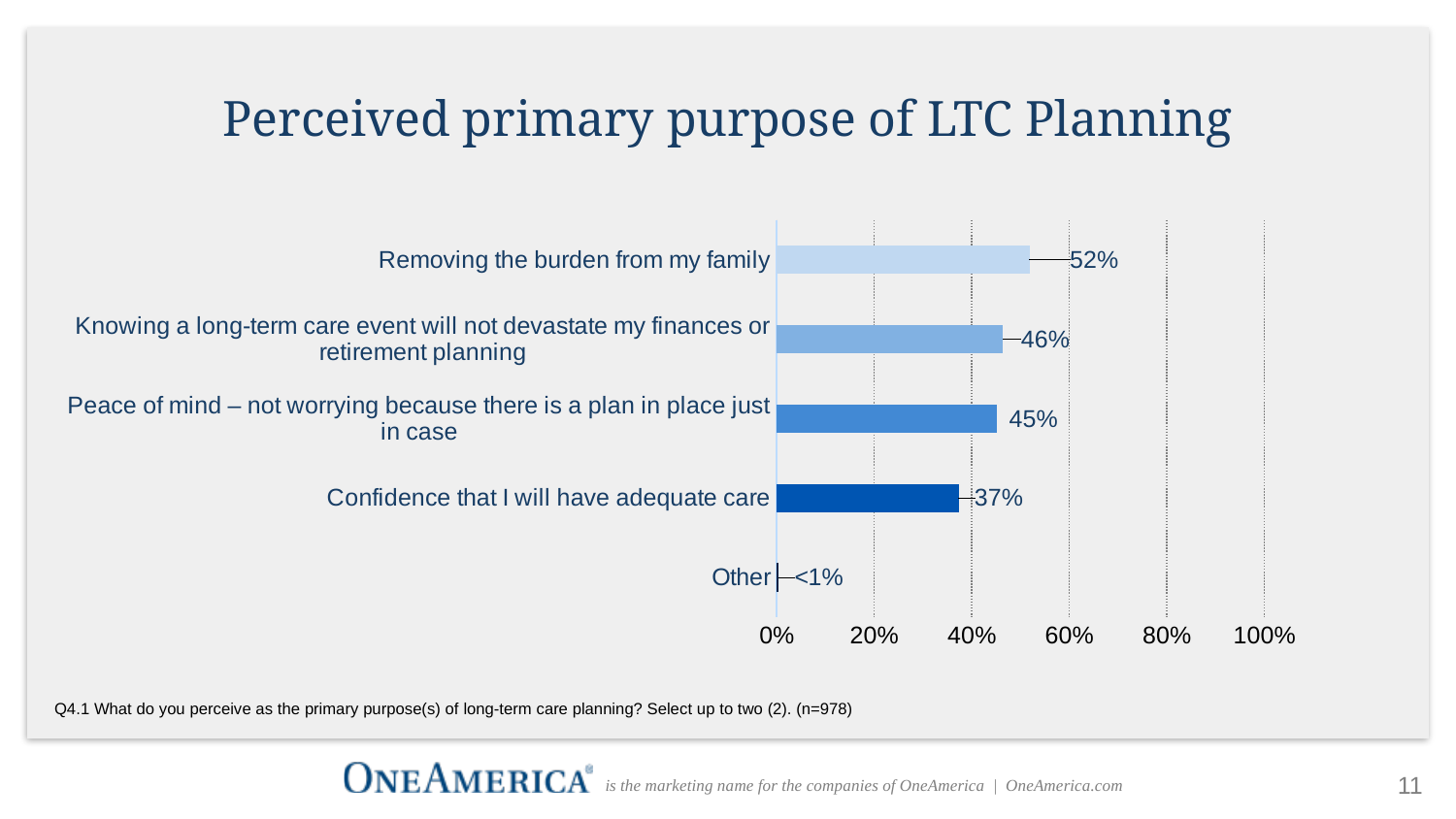
Which is larger: "Knowing a long-term care event will not devastate my finances or retirement planning" or "Confidence that I will have adequate care"? Knowing a long-term care event will not devastate my finances or retirement planning What is the title of the chart? Perceived primary purpose of LTC Planning Which category has the lowest value? Other Which category has the highest value? Removing the burden from my family What is the value shown for "Other"? <1% Is the value for "Removing the burden from my family" greater or less than 40%? greater What is the difference between "Removing the burden from my family" and "Confidence that I will have adequate care"? 15% What is the value for "Removing the burden from my family"? 52% What kind of chart is shown on the slide? Bar chart How many categories are shown in the chart? 5 What is the value for "Confidence that I will have adequate care"? 37% What is the value for "Peace of mind – not worrying because there is a plan in place just in case"? 45%